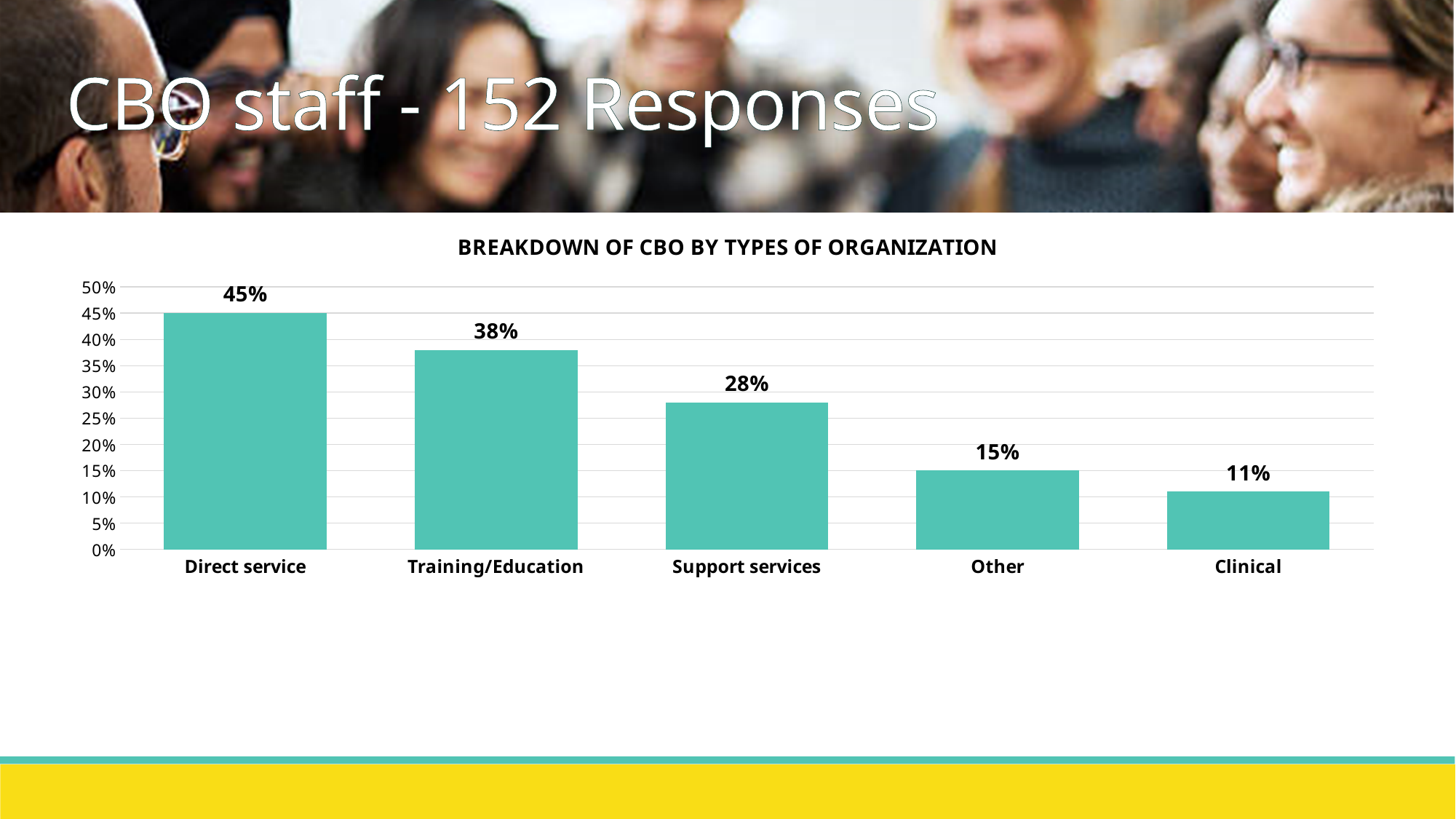
What is the value for Direct service? 45% How many categories are shown on the x axis? 5 What is the value for Clinical? 11% Which category has the highest value? Direct service What is the value for Support services? 28% What is the value for Training/Education? 38% What is the difference between the values for Other and Clinical? 4% What is the title of the chart? BREAKDOWN OF CBO BY TYPES OF ORGANIZATION Which is larger, the value for Support services or the value for Other? Support services Which category has the lowest value? Clinical What is the difference between the values for Direct service and Training/Education? 7% What kind of chart is shown on the slide? Bar chart